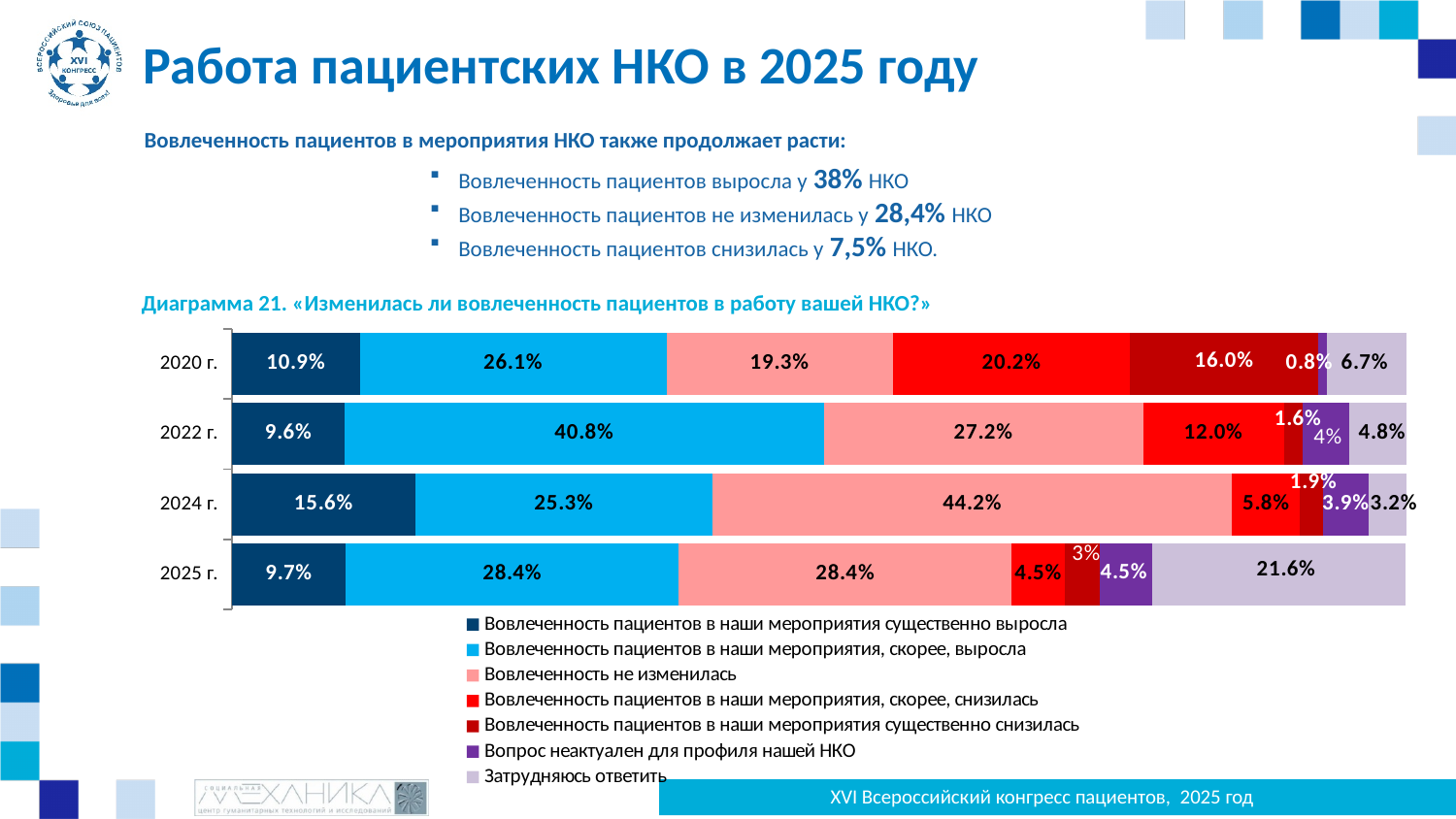
В каком году доля ответа «Вовлеченность пациентов в наши мероприятия, скорее, снизилась» была наименьшей? 2025 г. В каком году доля ответа «Вовлеченность пациентов в наши мероприятия существенно выросла» была наибольшей? 2024 г. Сколько серий перечислено в легенде диаграммы 21? 7 Какова доля ответа «Затрудняюсь ответить» в 2025 г.? 21.6% На сколько процентных пунктов доля ответа «Вовлеченность не изменилась» в 2024 г. больше, чем в 2025 г.? 15.8 Что больше: доля ответа «Затрудняюсь ответить» в 2020 г. или в 2025 г.? 2025 г. Какой тип диаграммы показан на слайде? Горизонтальная столбчатая диаграмма с накоплением Сколько лет (категорий) представлено на диаграмме 21? 4 Как меняется доля ответа «Вовлеченность пациентов в наши мероприятия, скорее, снизилась» от 2020 г. к 2025 г.? Снижается Какова доля ответа «Вовлеченность пациентов в наши мероприятия существенно снизилась» в 2020 г.? 16.0% Какова доля ответа «Вовлеченность пациентов в наши мероприятия, скорее, выросла» в 2022 г.? 40.8% Какова доля ответа «Вовлеченность не изменилась» в 2024 г.? 44.2%